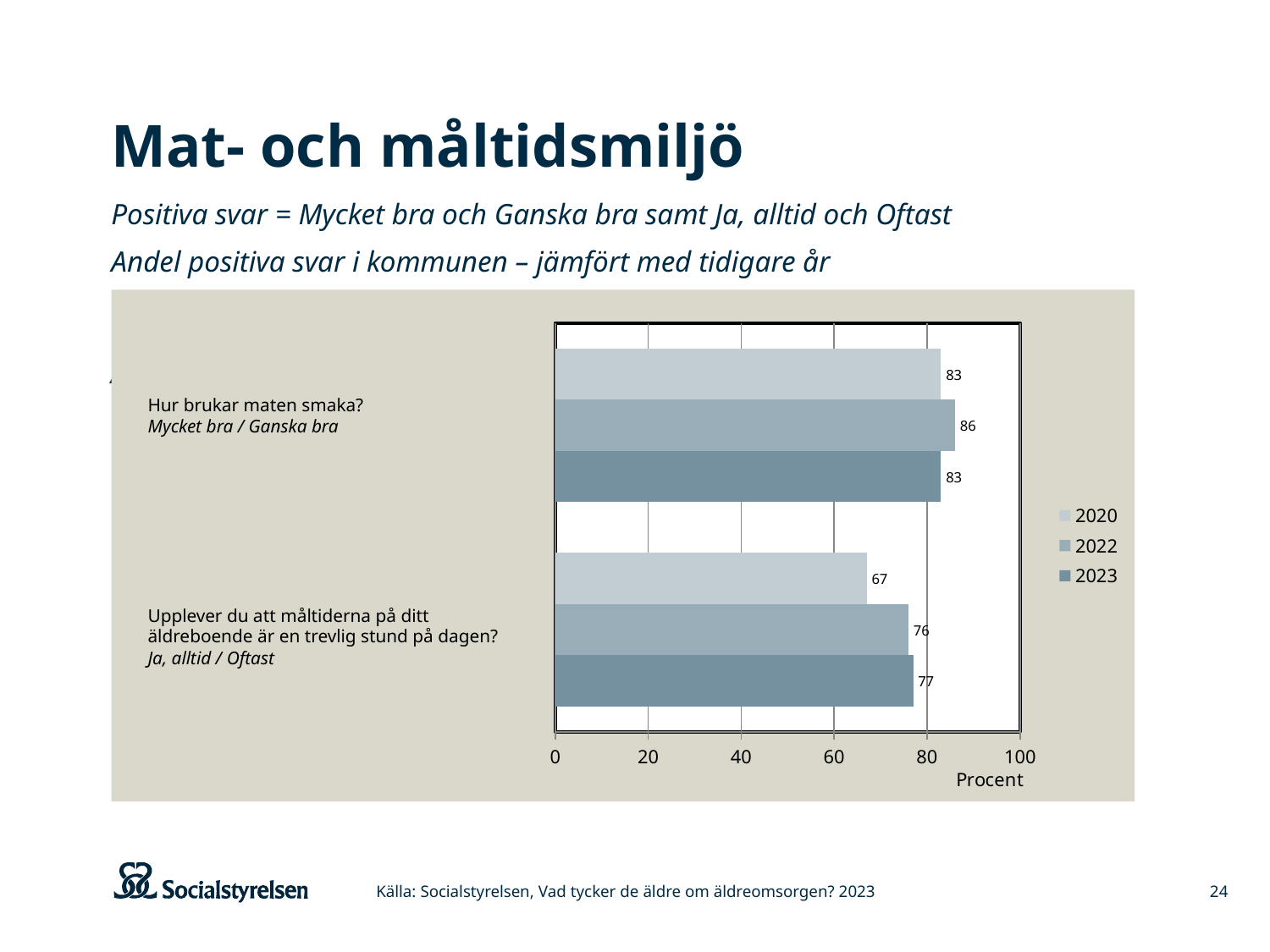
What is the label on the horizontal axis of the chart? Procent How many series does the legend list? 3 How many question categories are shown in the chart? 2 Which year has the highest value for "Hur brukar maten smaka?"? 2022 What is the value for 2020 for "Upplever du att måltiderna på ditt äldreboende är en trevlig stund på dagen?"? 67 What is the value for 2023 for "Upplever du att måltiderna på ditt äldreboende är en trevlig stund på dagen?"? 77 Which year has the lowest value for "Upplever du att måltiderna på ditt äldreboende är en trevlig stund på dagen?"? 2020 What is the difference between the 2023 and 2020 values for "Upplever du att måltiderna på ditt äldreboende är en trevlig stund på dagen?"? 10 Which is larger for 2022: the value for "Hur brukar maten smaka?" or the value for "Upplever du att måltiderna på ditt äldreboende är en trevlig stund på dagen?"? Hur brukar maten smaka? What kind of chart is shown on the slide? Bar chart What is the value for 2022 for "Hur brukar maten smaka?"? 86 What is the value for 2023 for "Hur brukar maten smaka?"? 83